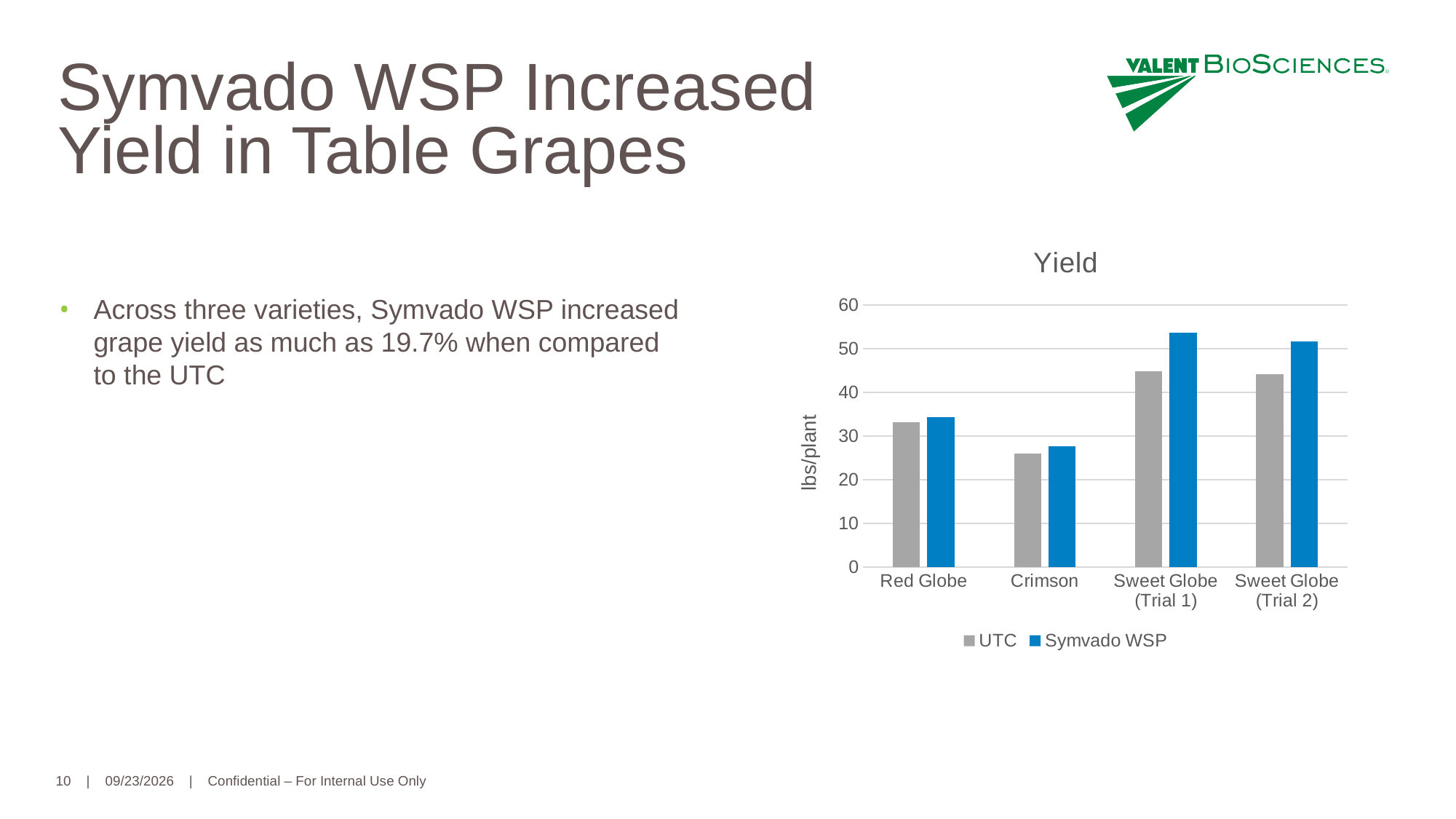
For Sweet Globe (Trial 1), which is larger: the UTC value or the Symvado WSP value? Symvado WSP Which category has the lowest Symvado WSP value in the Yield chart? Crimson Is the UTC value for Red Globe greater or less than 30? greater Which category has the lowest UTC value in the Yield chart? Crimson What kind of chart is shown on the slide? bar chart Is the Symvado WSP value for Sweet Globe (Trial 1) greater or less than 50? greater What is the label on the y axis of the Yield chart? lbs/plant Is the UTC value for Sweet Globe (Trial 2) greater or less than 50? less How many grape variety categories are shown on the x axis of the Yield chart? 4 How many series does the legend of the Yield chart list? 2 Which is larger: the UTC value for Red Globe or the UTC value for Crimson? Red Globe